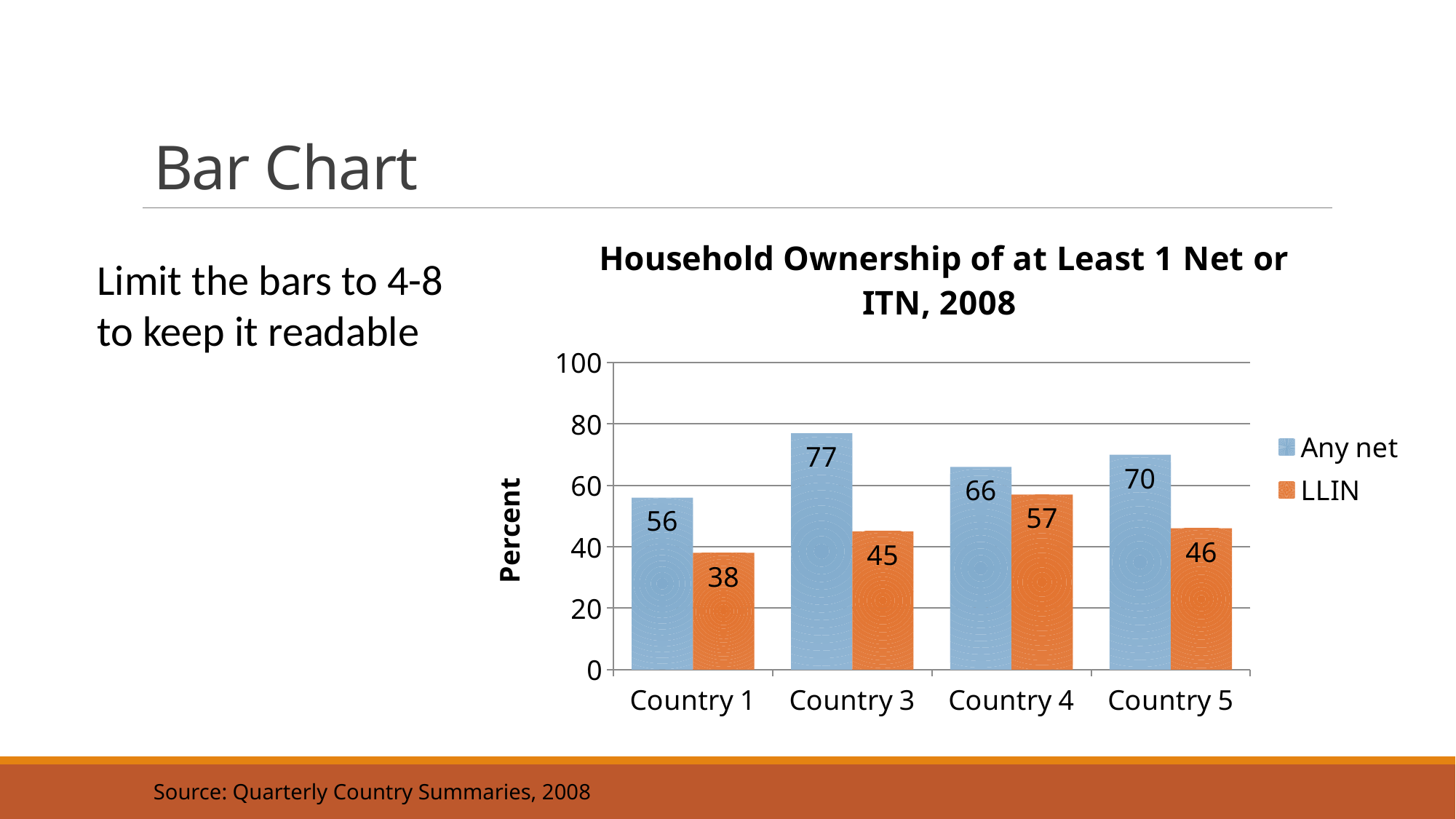
What is the LLIN value for Country 1? 38 What is the difference between the Any net and LLIN values for Country 3? 32 How many countries are shown on the x axis? 4 Which country has the highest Any net value? Country 3 How many series does the legend list? 2 What is the Any net value for Country 3? 77 Which country has the lowest LLIN value? Country 1 Is the Any net value for Country 1 greater or less than 60? less What kind of chart is shown on the slide? bar chart What is the title of the chart? Household Ownership of at Least 1 Net or ITN, 2008 What is the LLIN value for Country 4? 57 Which is larger for Country 5, the Any net value or the LLIN value? Any net